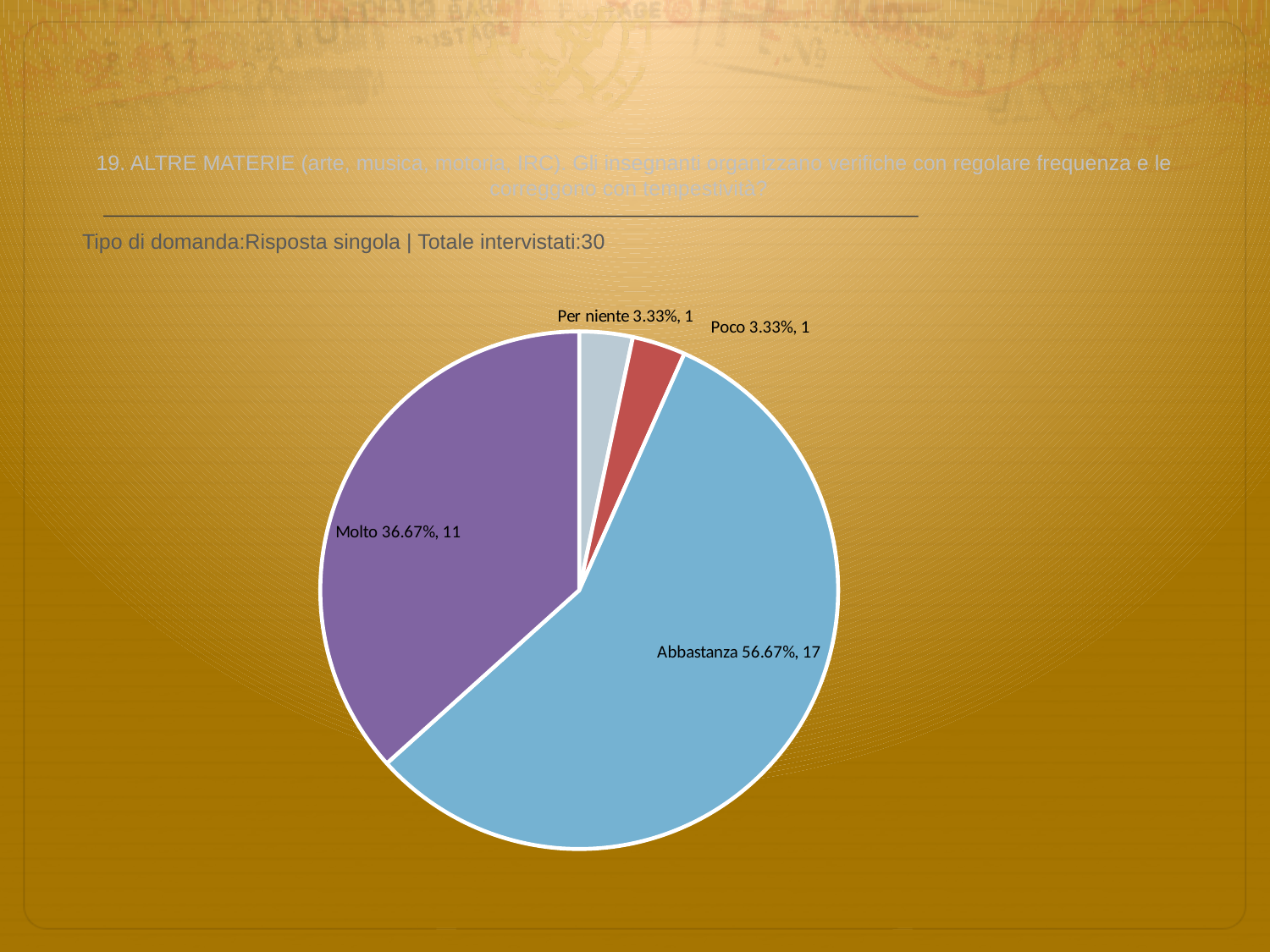
How many respondents answered Molto? 11 What is the total number of respondents across all slices of the pie? 30 What percentage of the pie does the Abbastanza slice represent? 56.67% What is the difference in respondent count between Abbastanza and Molto? 6 Which response category has the largest slice of the pie? Abbastanza How many respondents answered Per niente? 1 What colour is the Abbastanza slice of the pie? light blue How many slices does the pie chart have? 4 Which slice is larger, Molto or Abbastanza? Abbastanza What percentage is shown for the Poco slice? 3.33% What kind of chart is shown on the slide? pie chart What is the combined percentage of the Per niente and Poco slices? 6.66%